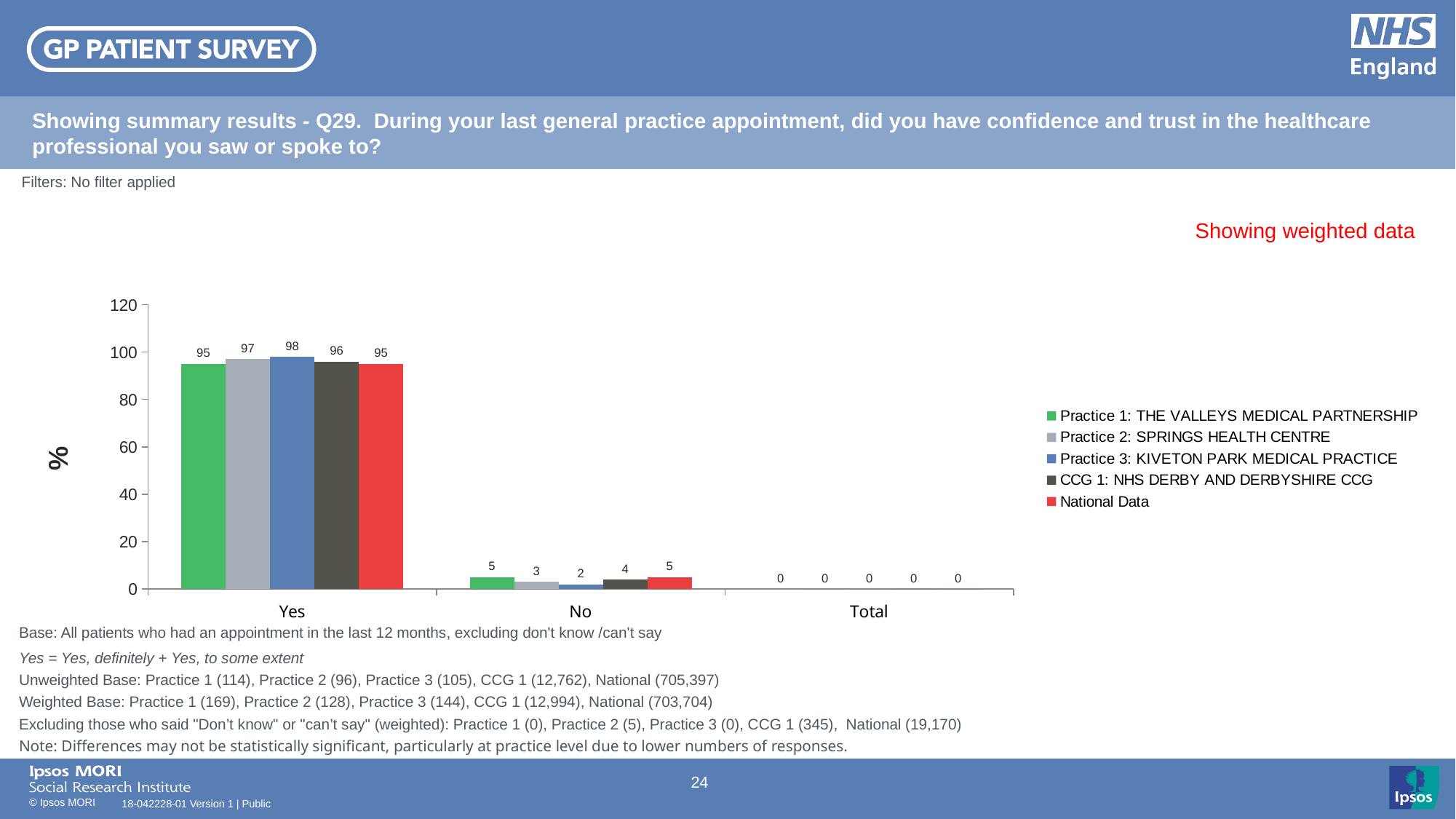
What kind of chart is shown on the slide? bar chart What is the label on the y axis? % Is the value for CCG 1: NHS DERBY AND DERBYSHIRE CCG in the Yes category greater or less than 80? greater Which series has the highest value in the Yes category? Practice 3: KIVETON PARK MEDICAL PRACTICE How many series does the legend list? 5 Which series has the lowest value in the No category? Practice 3: KIVETON PARK MEDICAL PRACTICE What is the value for Practice 2: SPRINGS HEALTH CENTRE in the Yes category? 97 Which is larger in the No category: Practice 1: THE VALLEYS MEDICAL PARTNERSHIP or Practice 2: SPRINGS HEALTH CENTRE? Practice 1: THE VALLEYS MEDICAL PARTNERSHIP What is the difference between the Yes values for Practice 3: KIVETON PARK MEDICAL PRACTICE and Practice 1: THE VALLEYS MEDICAL PARTNERSHIP? 3 What is the value for National Data in the No category? 5 What is the value for Practice 3: KIVETON PARK MEDICAL PRACTICE in the Yes category? 98 How many categories are shown on the x axis? 3